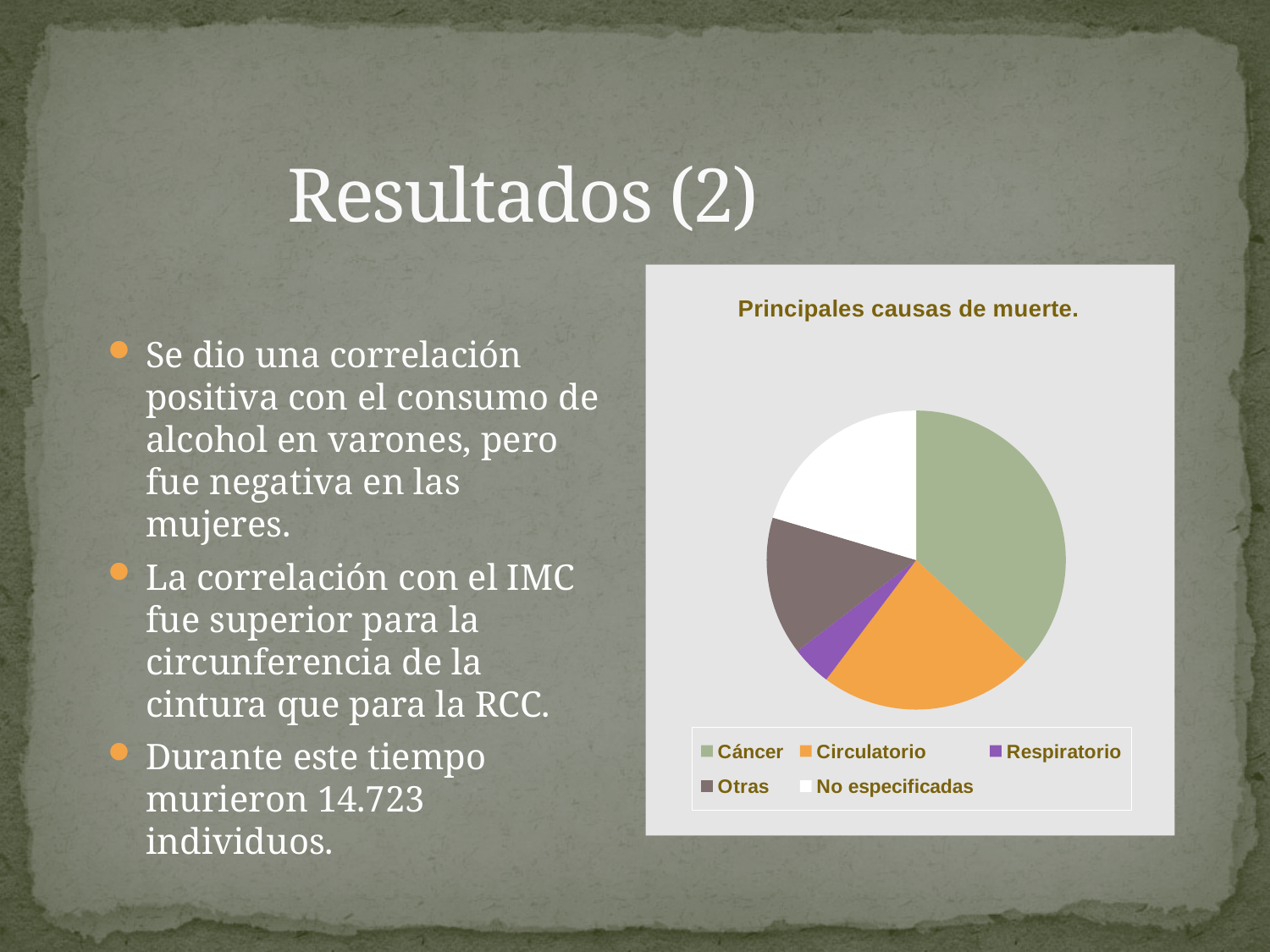
Which slice is larger, No especificadas or Respiratorio? No especificadas Which slice is larger, Circulatorio or Otras? Circulatorio What colour represents Circulatorio in the pie chart? orange How many categories does the pie chart show? 5 Which slice is larger, Cáncer or Otras? Cáncer Which category has the smallest slice of the pie? Respiratorio What is the title of the chart? Principales causas de muerte. What kind of chart is shown on the slide? pie chart Which category has the largest slice of the pie? Cáncer